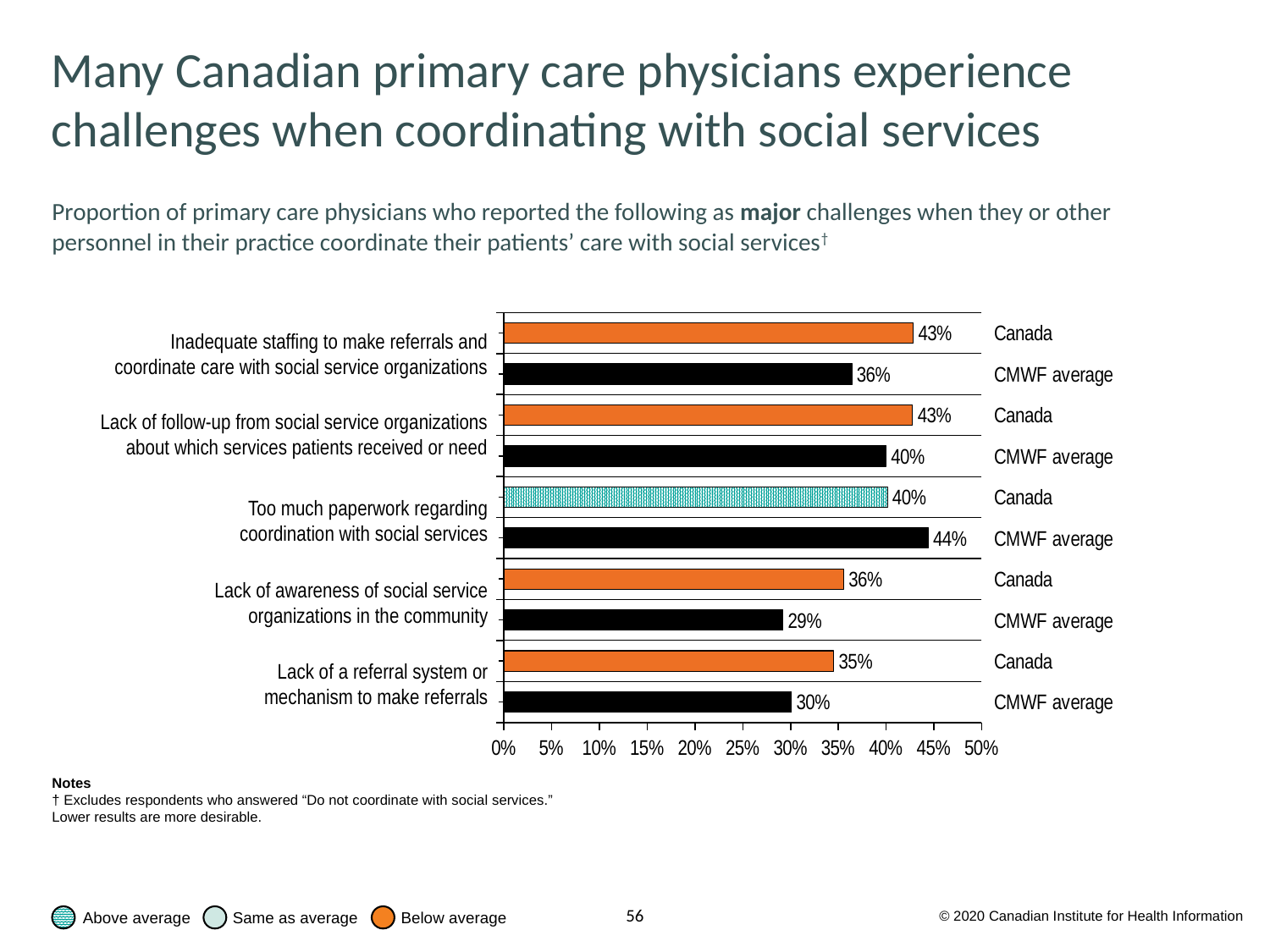
What is the Canada value for "Too much paperwork regarding coordination with social services"? 40% What type of chart is shown on the slide? Bar chart For "Too much paperwork regarding coordination with social services", which is larger: the Canada value or the CMWF average? CMWF average What is the CMWF average for "Lack of awareness of social service organizations in the community"? 29% Is the Canada value for "Lack of follow-up from social service organizations about which services patients received or need" greater or less than 40%? greater What is the maximum value shown on the chart's horizontal axis? 50% How many challenge categories are shown in the chart? 5 Which challenge has the highest CMWF average value? Too much paperwork regarding coordination with social services What is the CMWF average for "Inadequate staffing to make referrals and coordinate care with social service organizations"? 36% What is the difference between the Canada value and the CMWF average for "Lack of awareness of social service organizations in the community"? 7 percentage points What is the Canada value for "Lack of a referral system or mechanism to make referrals"? 35% Which challenge has the lowest CMWF average value? Lack of awareness of social service organizations in the community